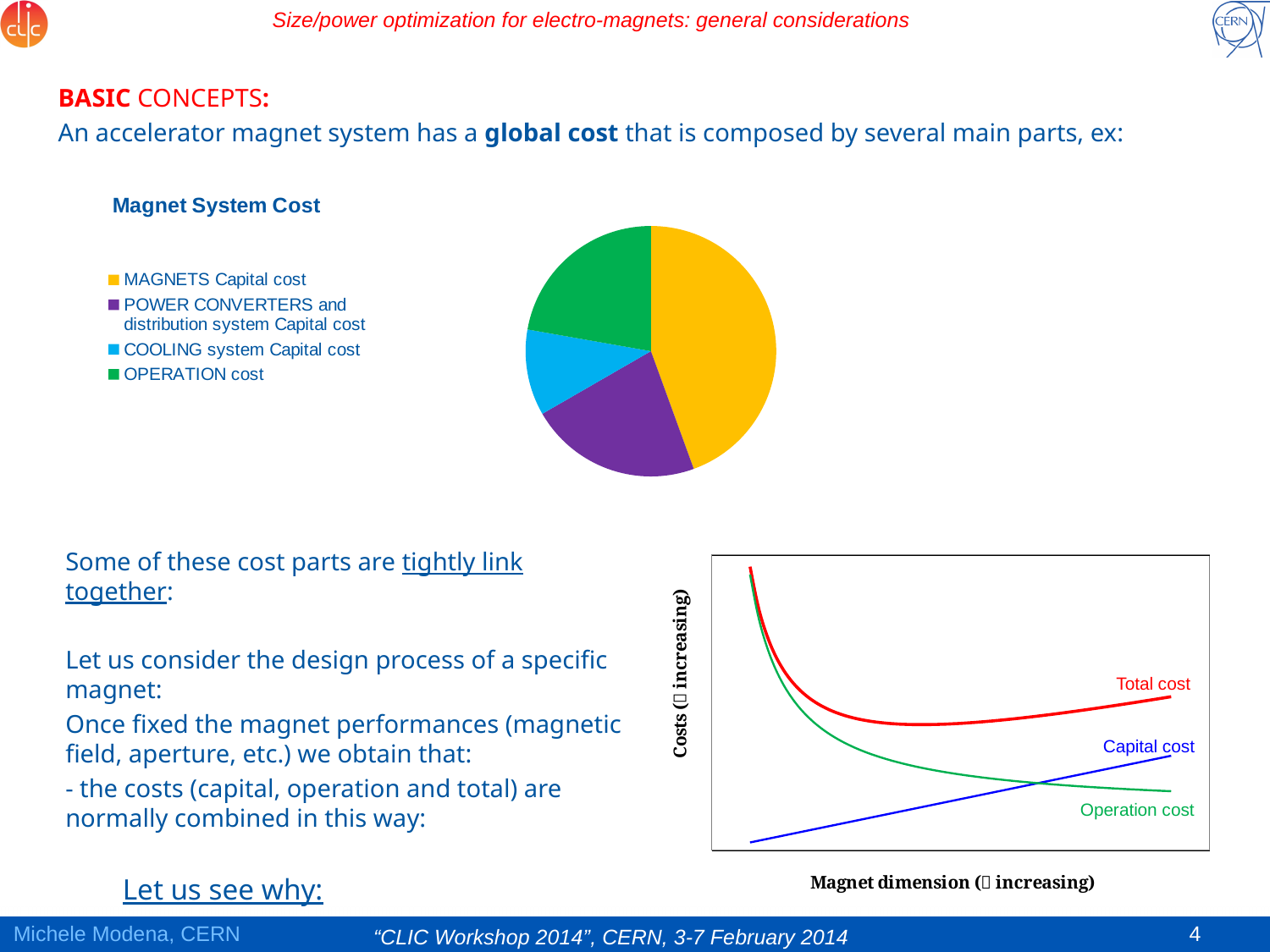
What kind of chart is the 'Magnet System Cost' chart? pie chart What kind of chart is the chart at the bottom right of the slide? line chart What is the x-axis label of the bottom-right line chart? Magnet dimension (increasing) In the 'Magnet System Cost' pie chart, what colour is the OPERATION cost slice? green How many slices does the 'Magnet System Cost' pie chart have? 4 In the 'Magnet System Cost' pie chart, which category has the smallest slice? COOLING system Capital cost How many cost curves are plotted in the bottom-right line chart? 3 In the 'Magnet System Cost' pie chart, which category has the largest slice? MAGNETS Capital cost In the bottom-right line chart, does the Capital cost curve rise or fall as magnet dimension increases? rises In the 'Magnet System Cost' pie chart, which slice is larger: MAGNETS Capital cost or POWER CONVERTERS and distribution system Capital cost? MAGNETS Capital cost In the 'Magnet System Cost' pie chart, which slice is larger: COOLING system Capital cost or OPERATION cost? OPERATION cost In the bottom-right line chart, does the Operation cost curve rise or fall as magnet dimension increases? falls